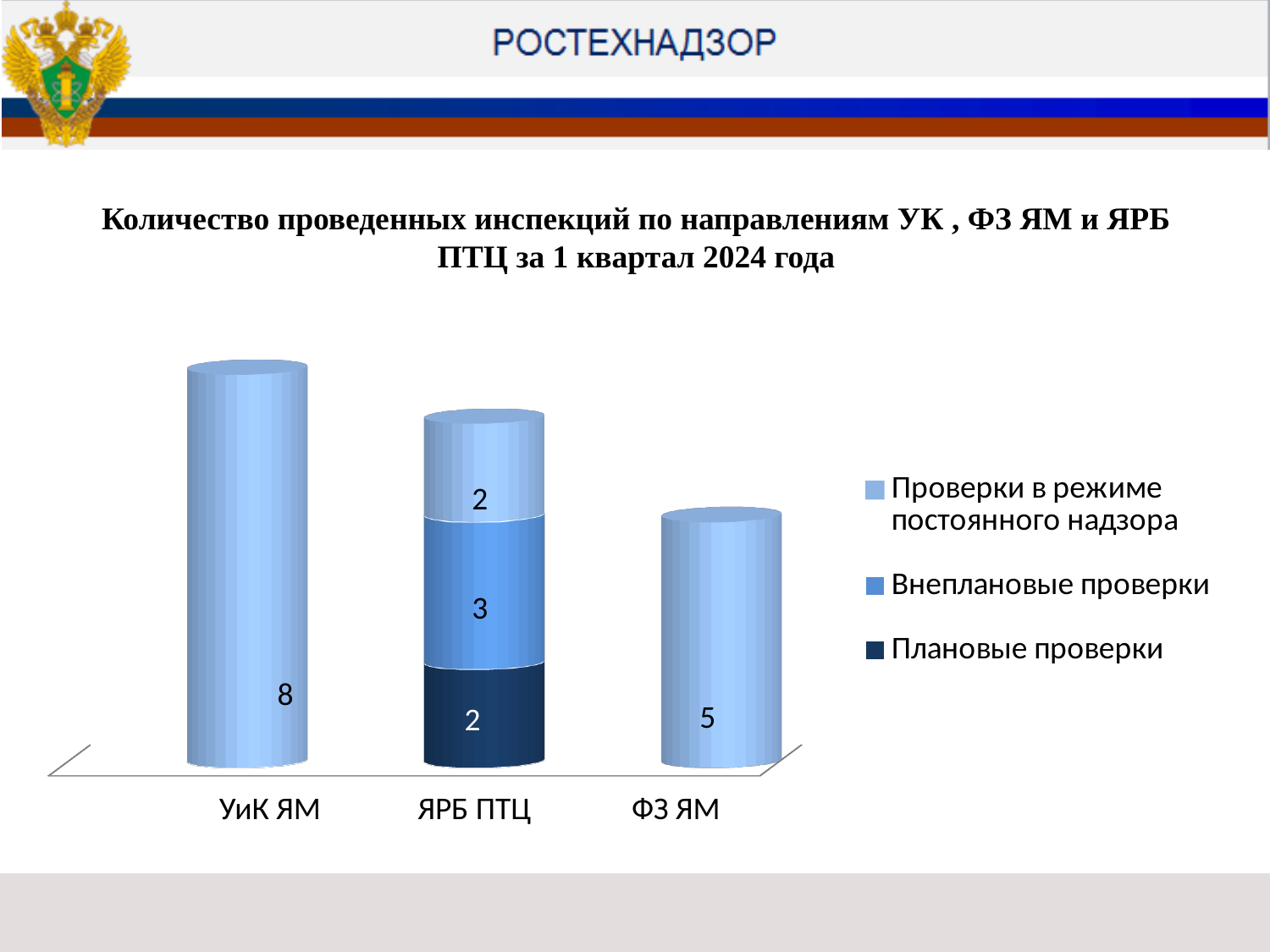
How many series does the legend list? 3 Which is larger: the Внеплановые проверки value for ЯРБ ПТЦ or the Плановые проверки value for ЯРБ ПТЦ? Внеплановые проверки What is the value for Внеплановые проверки for ЯРБ ПТЦ? 3 How many categories are shown on the x axis? 3 Which category has the highest total value? УиК ЯМ What is the value for Проверки в режиме постоянного надзора for УиК ЯМ? 8 What is the value for Плановые проверки for ЯРБ ПТЦ? 2 What is the total of the stacked bar for ЯРБ ПТЦ? 7 What is the value for Проверки в режиме постоянного надзора for ФЗ ЯМ? 5 What kind of chart is shown on the slide? Stacked bar chart Which category has the lowest total value? ФЗ ЯМ What is the difference between the value for УиК ЯМ and the value for ФЗ ЯМ? 3